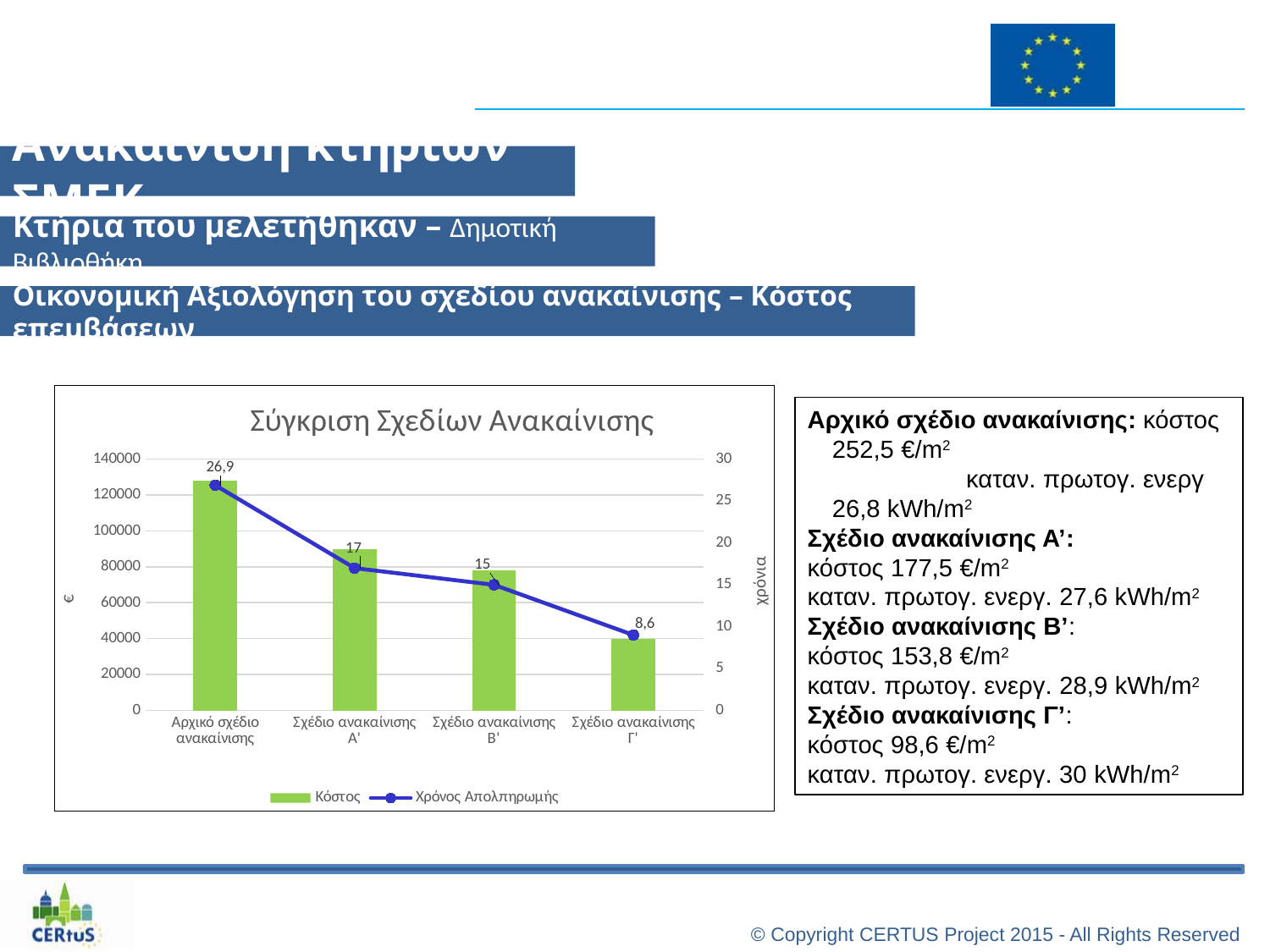
What is the payback time (Χρόνος Αποληρωμής) for Σχέδιο ανακαίνισης Γ'? 8,6 How many series does the legend list? 2 Is the cost (Κόστος) for Σχέδιο ανακαίνισης Γ' greater or less than 60000? less How many renovation plans are shown on the x axis? 4 What is the payback time (Χρόνος Αποληρωμής) for Αρχικό σχέδιο ανακαίνισης? 26,9 What is the difference in payback time between Αρχικό σχέδιο ανακαίνισης and Σχέδιο ανακαίνισης Γ'? 18,3 Which plan has the highest payback time (Χρόνος Αποληρωμής)? Αρχικό σχέδιο ανακαίνισης Does the payback time rise or fall from left to right across the plans? fall Which has a larger payback time, Σχέδιο ανακαίνισης Α' or Σχέδιο ανακαίνισης Β'? Σχέδιο ανακαίνισης Α' Is the cost (Κόστος) for Αρχικό σχέδιο ανακαίνισης greater or less than 120000? greater What is the payback time (Χρόνος Αποληρωμής) for Σχέδιο ανακαίνισης Α'? 17 Which plan has the lowest cost (Κόστος)? Σχέδιο ανακαίνισης Γ'